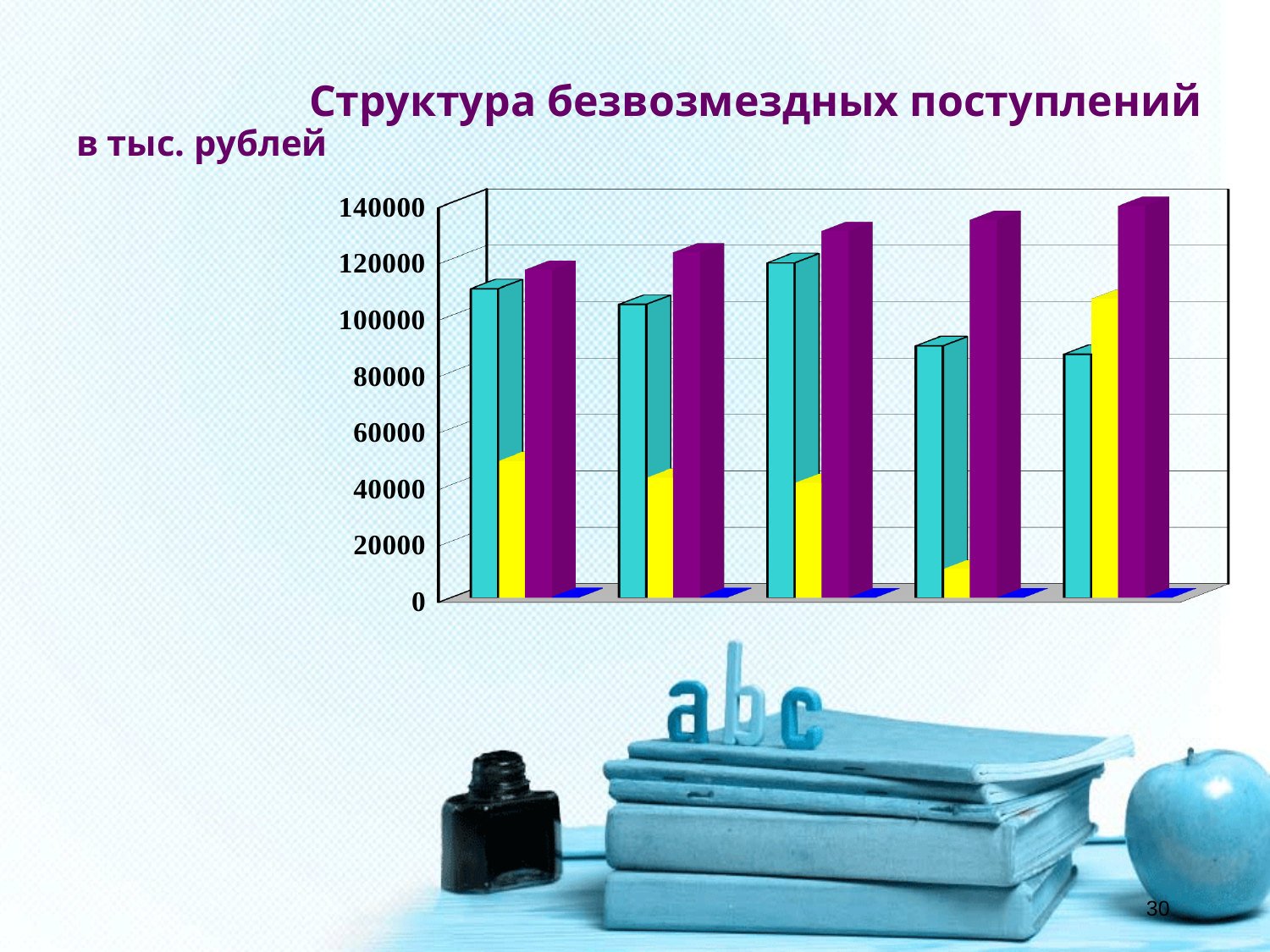
Do the purple bars rise or fall from left to right across the groups? rise Is the value of the cyan bar in the fourth group from the left greater or less than 100000? less What is the title of the chart on the slide? Структура безвозмездных поступлений в тыс. рублей What kind of chart is shown on the slide? bar chart Is the value of the purple bar in the third group from the left greater or less than 120000? greater In the leftmost group, which is larger: the cyan bar or the purple bar? the purple bar In which group of bars is the yellow bar the tallest? the rightmost (fifth) group What is the highest value shown on the vertical axis of the chart? 140000 How many groups of bars are plotted in the chart? 5 Is the value of the yellow bar in the fourth group from the left greater or less than 20000? less